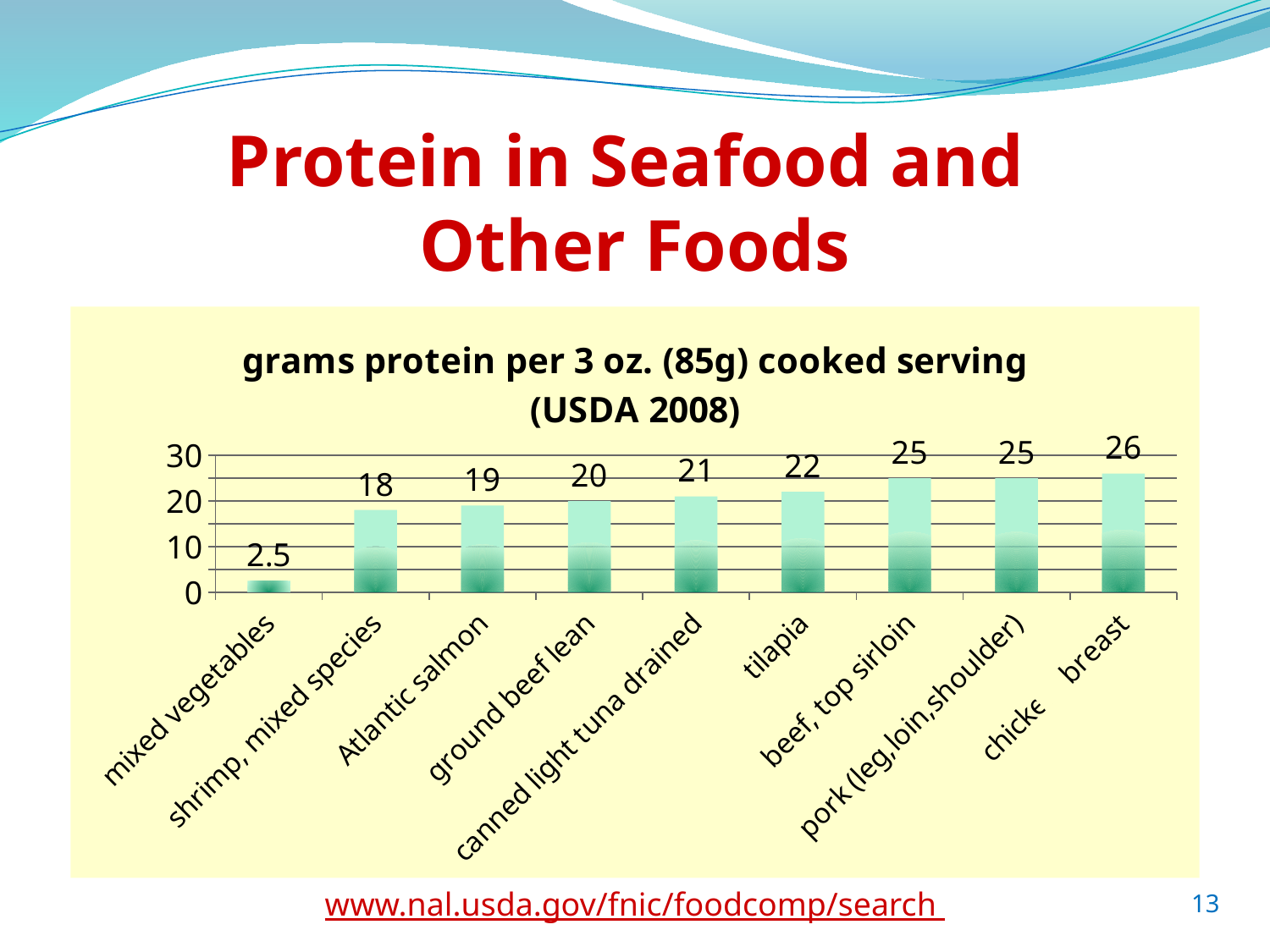
What kind of chart is shown on the slide? bar chart What is the difference between the values for tilapia and shrimp, mixed species? 4 Which is larger, the value for ground beef lean or the value for Atlantic salmon? ground beef lean What is the value for Atlantic salmon? 19 How many categories are shown in the chart? 9 What is the title of the chart? grams protein per 3 oz. (85g) cooked serving (USDA 2008) What is the value for tilapia? 22 Is the value for beef, top sirloin greater or less than 20? greater Which category has the lowest value? mixed vegetables Which category has the highest value? chicken breast What is the value for canned light tuna drained? 21 What is the value for mixed vegetables? 2.5